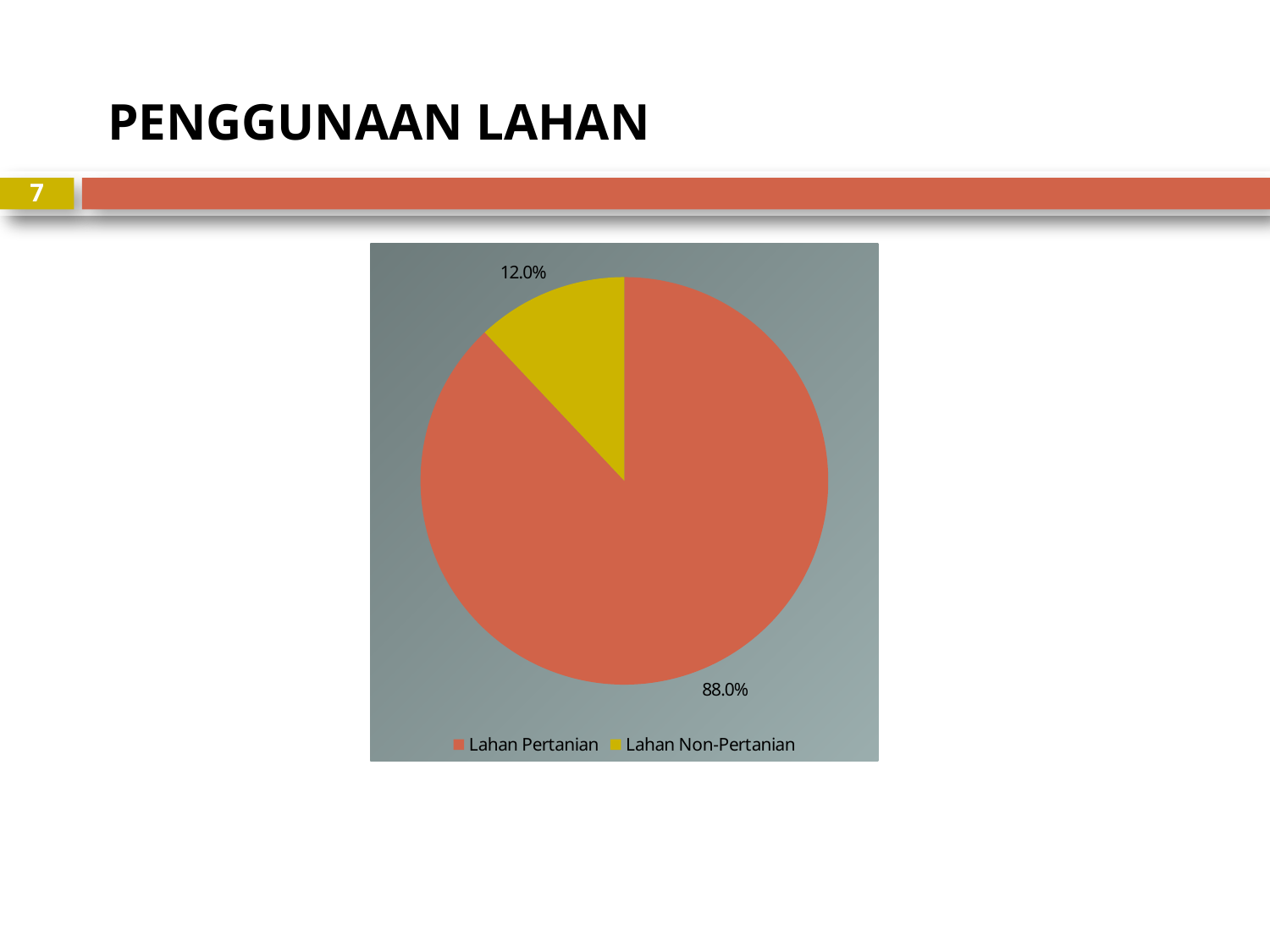
Which category has the smallest slice of the pie? Lahan Non-Pertanian Which is larger, the slice for Lahan Pertanian or the slice for Lahan Non-Pertanian? Lahan Pertanian What is the title of the slide containing the chart? PENGGUNAAN LAHAN What is the difference in percentage points between Lahan Pertanian and Lahan Non-Pertanian? 76.0 percentage points How many categories does the pie chart show? 2 What colour is the slice for Lahan Non-Pertanian? yellow What share of the pie does Lahan Pertanian represent? 88.0% What kind of chart is shown on the slide? pie chart How many entries does the legend list? 2 Which category has the largest slice of the pie? Lahan Pertanian What share of the pie does Lahan Non-Pertanian represent? 12.0%